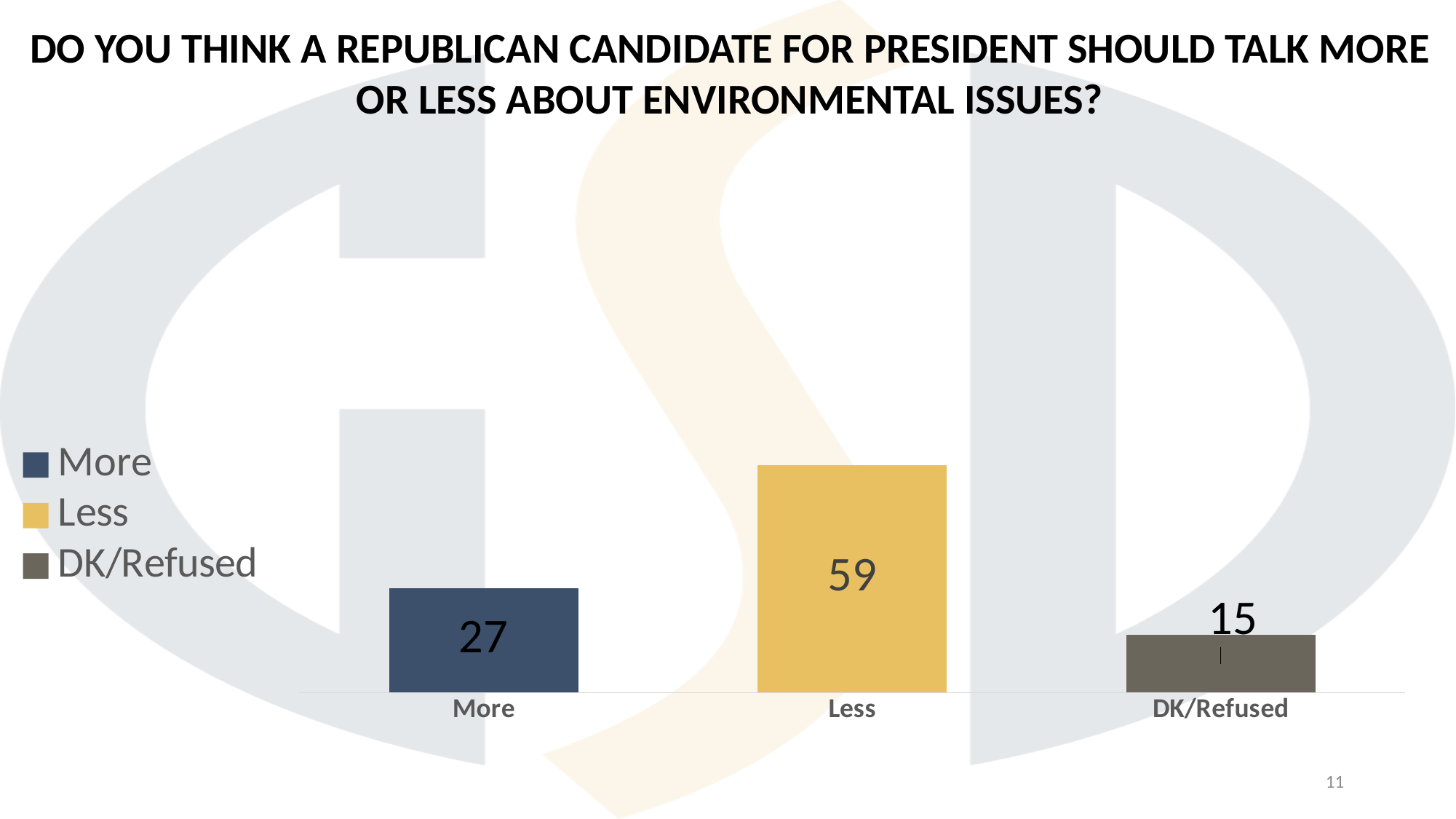
What is the value for "Less"? 59 What is the value for "DK/Refused"? 15 What is the difference between the values for "Less" and "More"? 32 What colour is the bar for "Less"? Yellow Which category has the lowest value? DK/Refused How many entries does the legend list? 3 What kind of chart is shown on the slide? Bar chart How many categories are shown on the x axis? 3 Which is larger, the value for "More" or the value for "DK/Refused"? More What is the value for "More"? 27 Which category has the highest value? Less What is the difference between the values for "More" and "DK/Refused"? 12